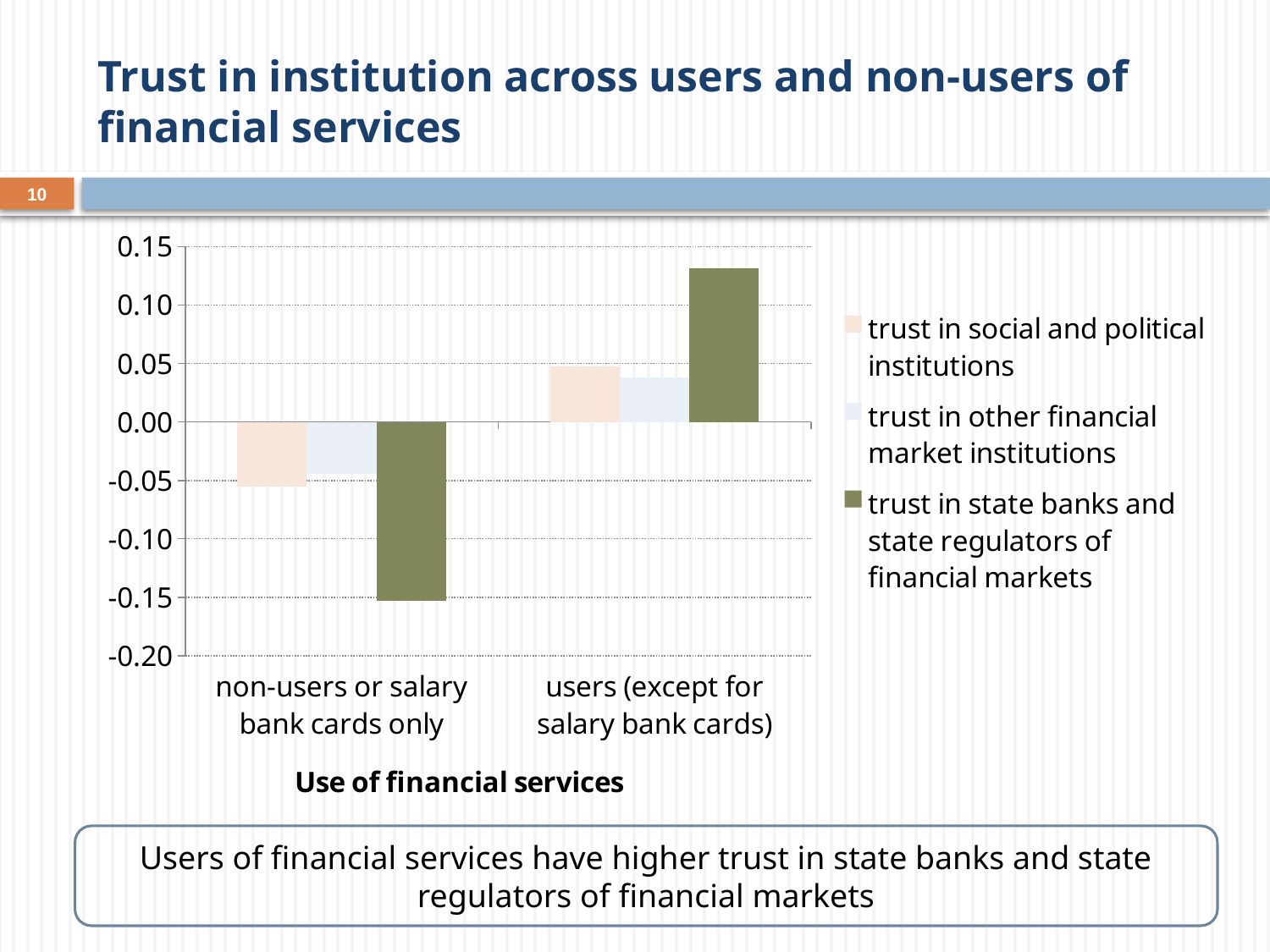
Which series is shown in dark green in the chart? trust in state banks and state regulators of financial markets What kind of chart is shown on the slide? bar chart How many series does the chart's legend list? 3 Which group has the larger value for trust in state banks and state regulators of financial markets: non-users or salary bank cards only, or users (except for salary bank cards)? users (except for salary bank cards) Is the value for trust in social and political institutions among non-users or salary bank cards only greater or less than 0.00? less Is the value for trust in state banks and state regulators of financial markets among users (except for salary bank cards) greater or less than 0.10? greater Is the value for trust in other financial market institutions among users (except for salary bank cards) greater or less than 0.05? less Which series has the lowest value for non-users or salary bank cards only? trust in state banks and state regulators of financial markets What is the title of the x axis of the chart? Use of financial services Which series has the highest value for users (except for salary bank cards)? trust in state banks and state regulators of financial markets How many categories are shown on the x axis of the chart? 2